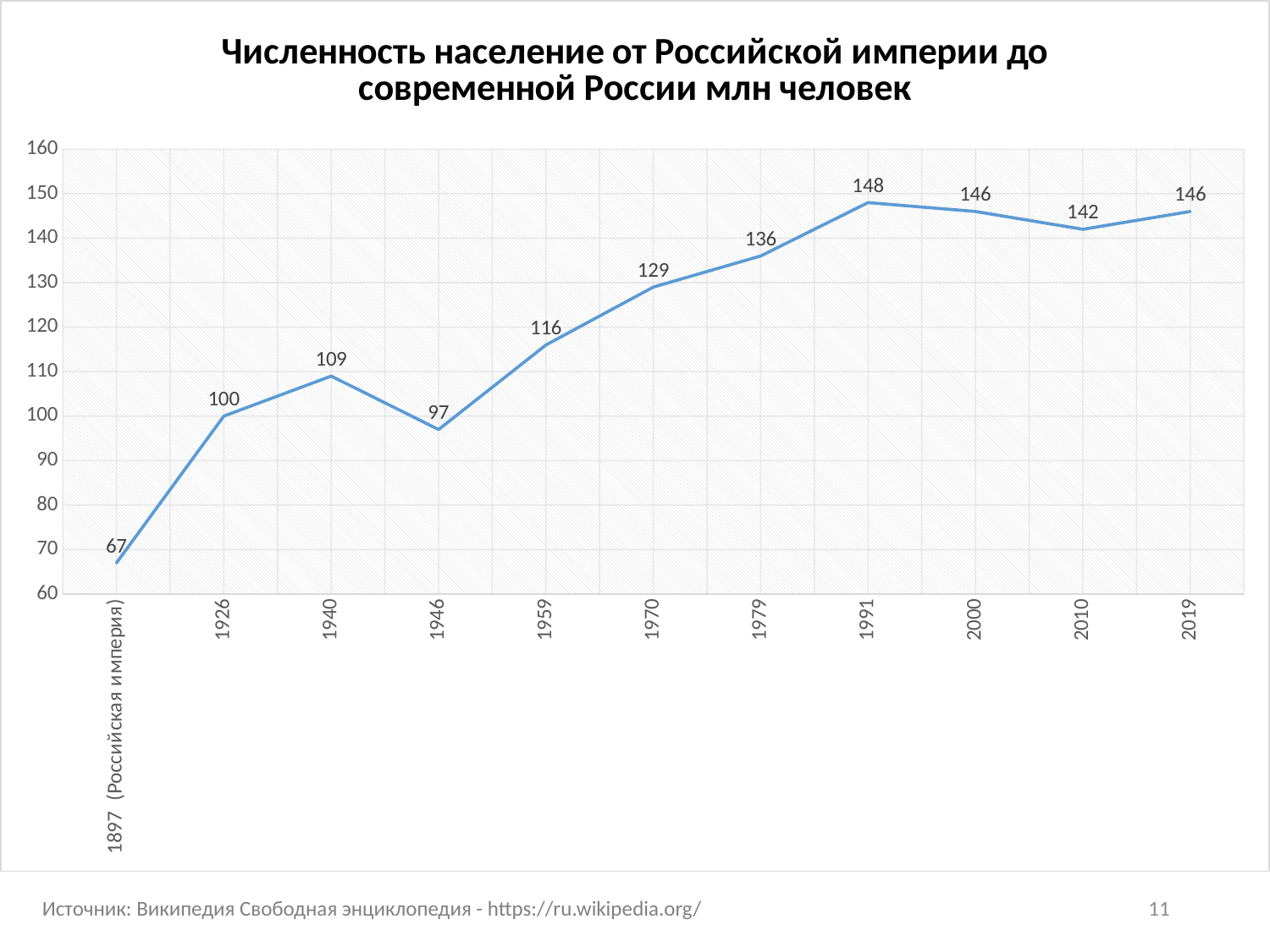
What is the title of the chart? Численность население от Российской империи до современной России млн человек Does the population value rise or fall between 1946 and 1991? rise Which is larger, the value for 1970 or the value for 1979? 1979 What is the population value shown for 1946? 97 Which year has the lowest population value on the chart? 1897 (Российская империя) What is the difference between the values for 1940 and 1946? 12 What is the population value shown for 1897 (Российская империя)? 67 What kind of chart is shown on the slide? line chart How many data points are plotted on the chart? 11 What is the population value shown for 1991? 148 Which year has the highest population value on the chart? 1991 What is the difference between the values for 1991 and 2010? 6